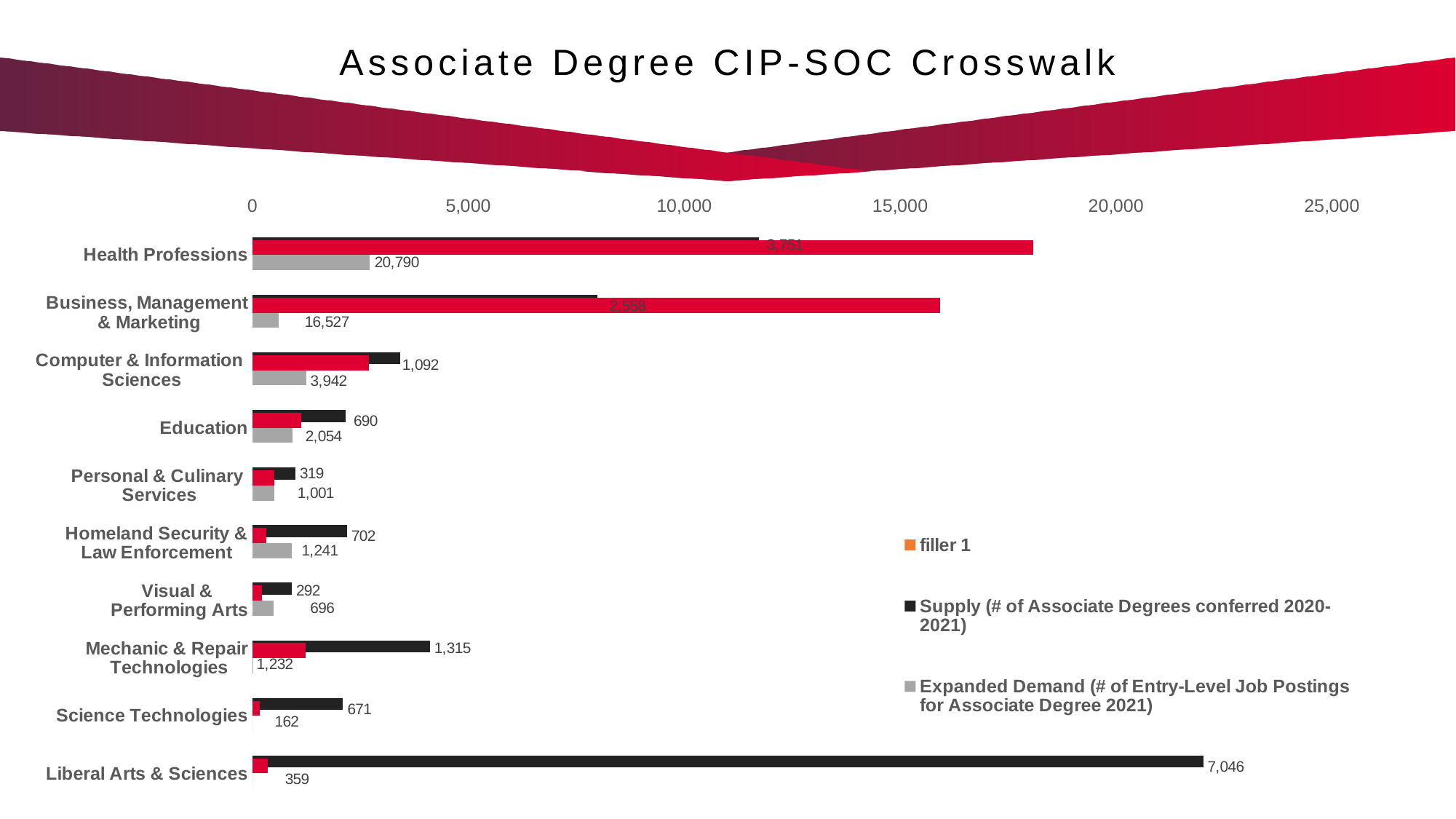
Which category has the highest Supply value? Liberal Arts & Sciences How many categories are shown on the chart? 10 For Mechanic & Repair Technologies, which is larger: Supply or Expanded Demand? Supply What kind of chart is shown on the slide? Bar chart What is the Supply value for Liberal Arts & Sciences? 7,046 How many series does the legend list? 3 Which category has the highest Expanded Demand value? Health Professions What is the Supply value for Computer & Information Sciences? 1,092